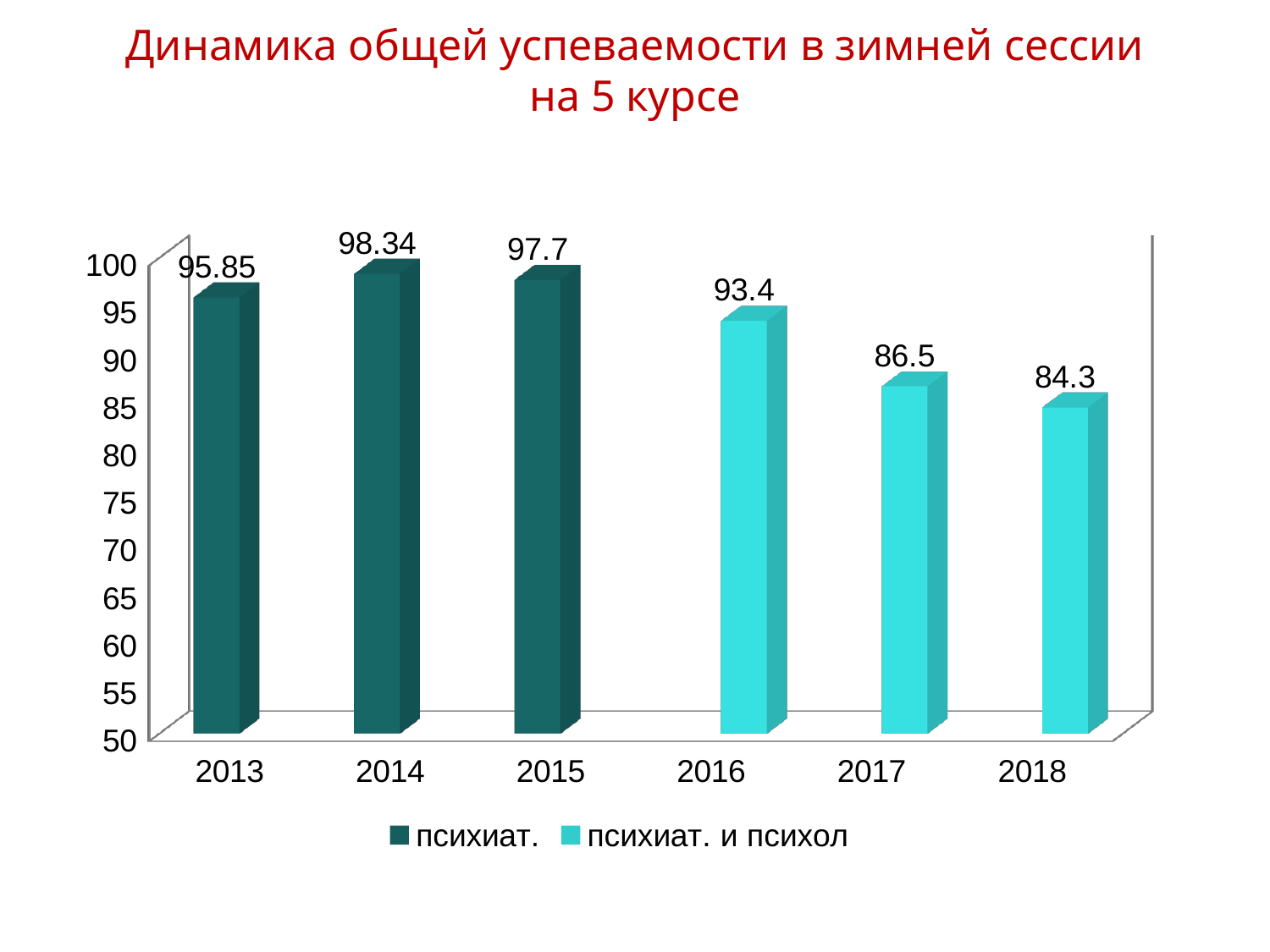
What is the difference between the values for 2016 and 2017? 6.9 Which year has the lowest value? 2018 How many years are shown on the x axis? 6 How many series does the legend list? 2 Which is larger, the value for 2013 or the value for 2015? 2015 Which year has the highest value? 2014 Is the value for 2017 greater or less than 90? less What is the difference between the values for 2014 and 2018? 14.04 What is the value for 2018? 84.3 What is the value for 2014? 98.34 What is the value for 2016? 93.4 What kind of chart is shown on the slide? bar chart